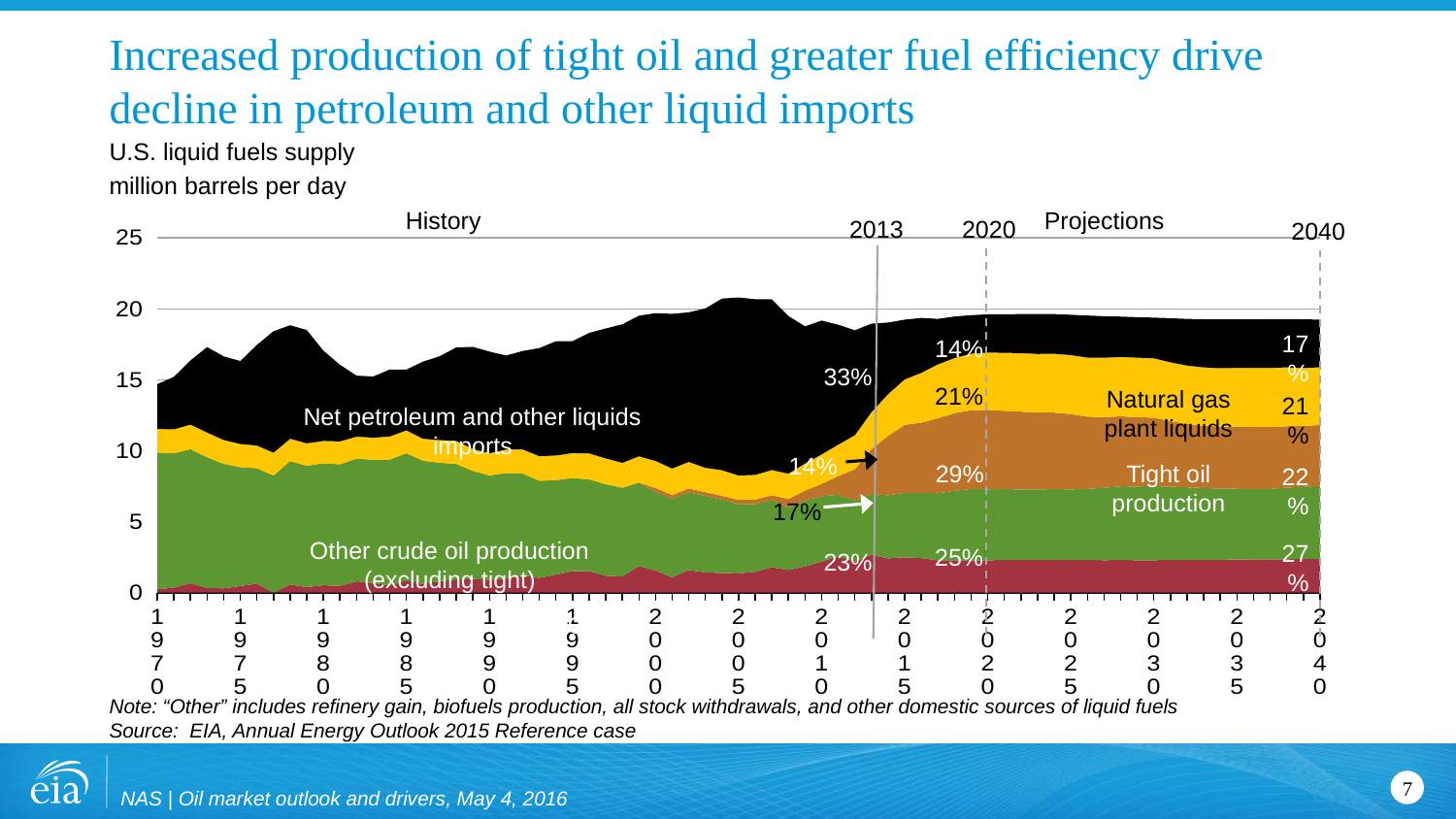
What share of U.S. liquid fuels supply do net petroleum and other liquids imports account for in 2020? 14% Which is larger in 2013: the share for net petroleum and other liquids imports or the share for tight oil production? net petroleum and other liquids imports What share of U.S. liquid fuels supply does other crude oil production (excluding tight) account for in 2040? 27% Is the total U.S. liquid fuels supply in 2040 greater or less than 15 million barrels per day? greater What share of U.S. liquid fuels supply do natural gas plant liquids account for in 2040? 21% What year separates the History and Projections sections of the chart? 2013 What share of U.S. liquid fuels supply do net petroleum and other liquids imports account for in 2013? 33% What share of U.S. liquid fuels supply does tight oil production account for in 2020? 29% Is the total U.S. liquid fuels supply in 1970 greater or less than 20 million barrels per day? less What unit is the y axis of the chart measured in? million barrels per day What kind of chart is shown on the slide? stacked area chart What share of U.S. liquid fuels supply does tight oil production account for in 2040? 22%